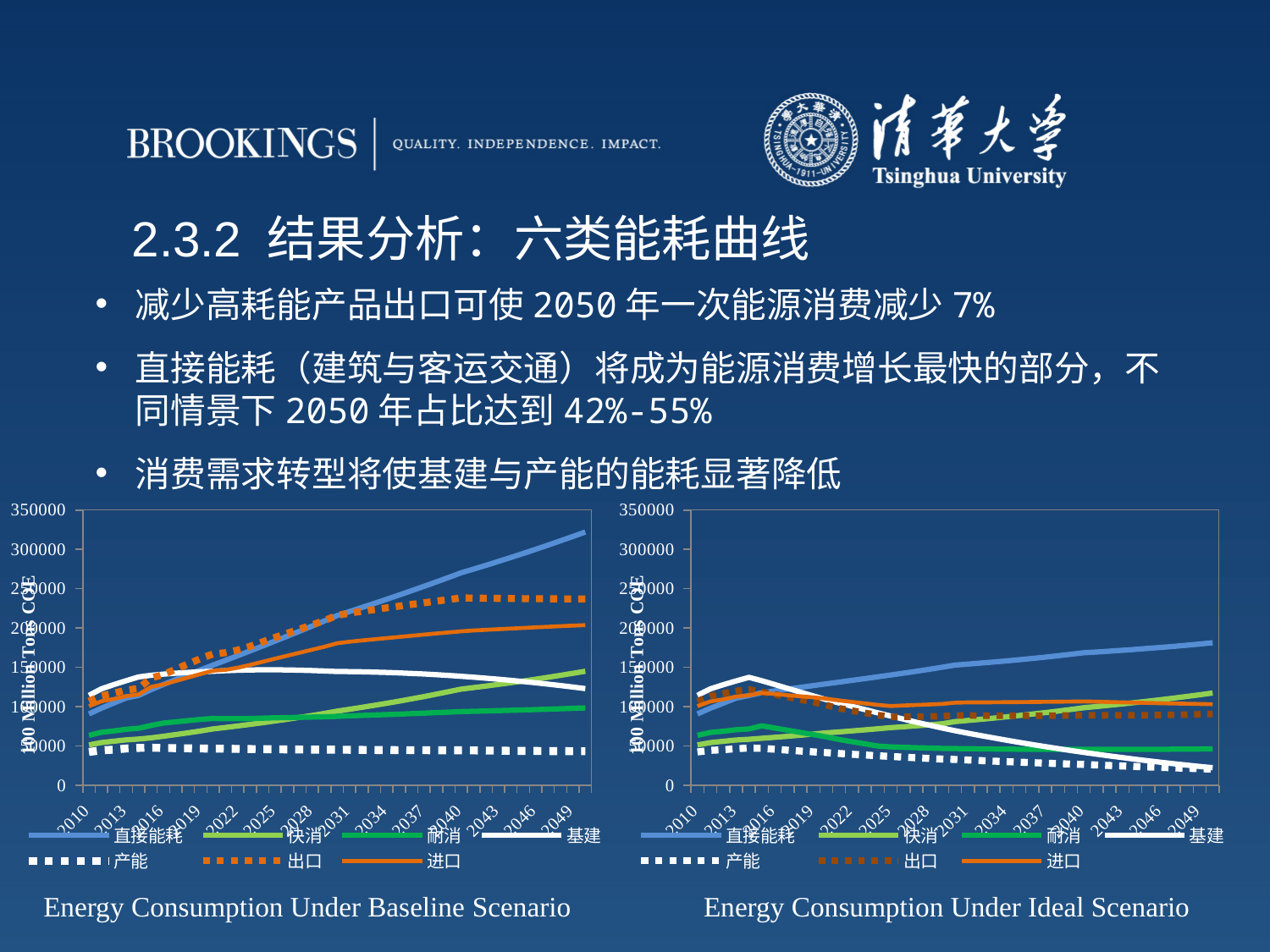
In the Energy Consumption Under Ideal Scenario chart, is the value for 基建 in 2049 greater or less than 50000? less How many series does the legend of the Energy Consumption Under Ideal Scenario chart list? 7 In the Energy Consumption Under Ideal Scenario chart, is the value for 直接能耗 in 2049 greater or less than 200000? less In the Energy Consumption Under Ideal Scenario chart, which series has the highest value in 2049? 直接能耗 What kind of chart is the Energy Consumption Under Baseline Scenario chart? line chart In the Energy Consumption Under Baseline Scenario chart, is the value for 直接能耗 in 2049 greater or less than 300000? greater In the Energy Consumption Under Ideal Scenario chart, does the 基建 series rise or fall from 2016 to 2049? fall In the Energy Consumption Under Baseline Scenario chart, which series has the lowest value in 2049? 产能 In the Energy Consumption Under Ideal Scenario chart, which is larger in 2049, 进口 or 基建? 进口 In the Energy Consumption Under Baseline Scenario chart, which is larger in 2049, 直接能耗 or 出口? 直接能耗 In the Energy Consumption Under Baseline Scenario chart, which series has the highest value in 2049? 直接能耗 What is the title shown below the left chart? Energy Consumption Under Baseline Scenario